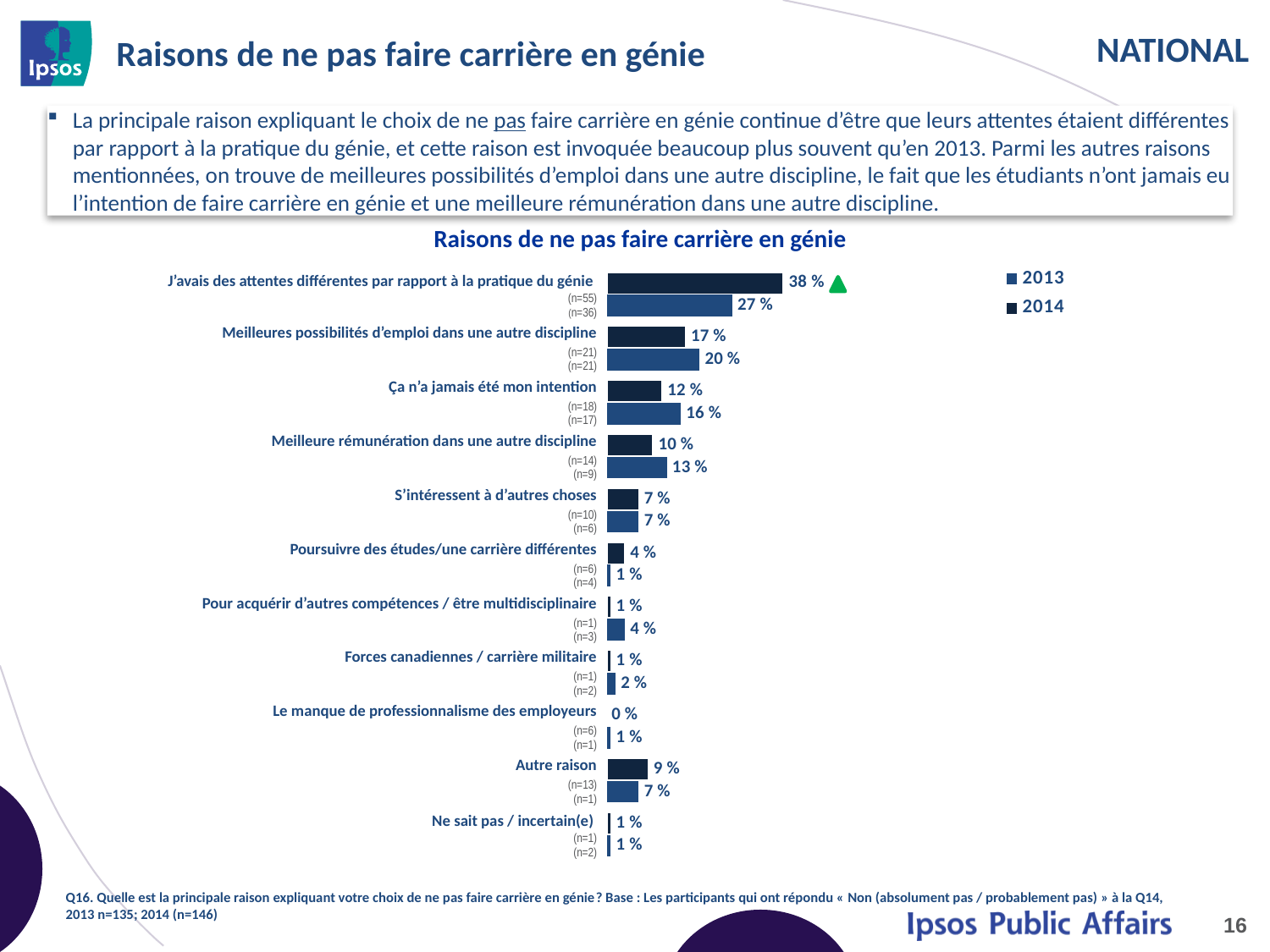
What is the value of the upper (darker) bar for "Le manque de professionnalisme des employeurs"? 0 % How many series does the chart legend list? 2 What is the value of the lower (lighter) bar for "J'avais des attentes différentes par rapport à la pratique du génie"? 27 % What is the value of the upper (darker) bar for "Autre raison"? 9 % What kind of chart is shown on the slide? bar chart What are the two entries in the chart legend? 2013 and 2014 What is the difference between the two bars for "J'avais des attentes différentes par rapport à la pratique du génie"? 11 % Which reason has the highest value in the chart? J'avais des attentes différentes par rapport à la pratique du génie For "Ça n'a jamais été mon intention", which bar is larger, the upper (darker) one or the lower (lighter) one? the lower (lighter) one How many reason categories are plotted in the chart? 11 What is the value of the upper (darker) bar for "J'avais des attentes différentes par rapport à la pratique du génie"? 38 % What is the value of the lower (lighter) bar for "Meilleures possibilités d'emploi dans une autre discipline"? 20 %